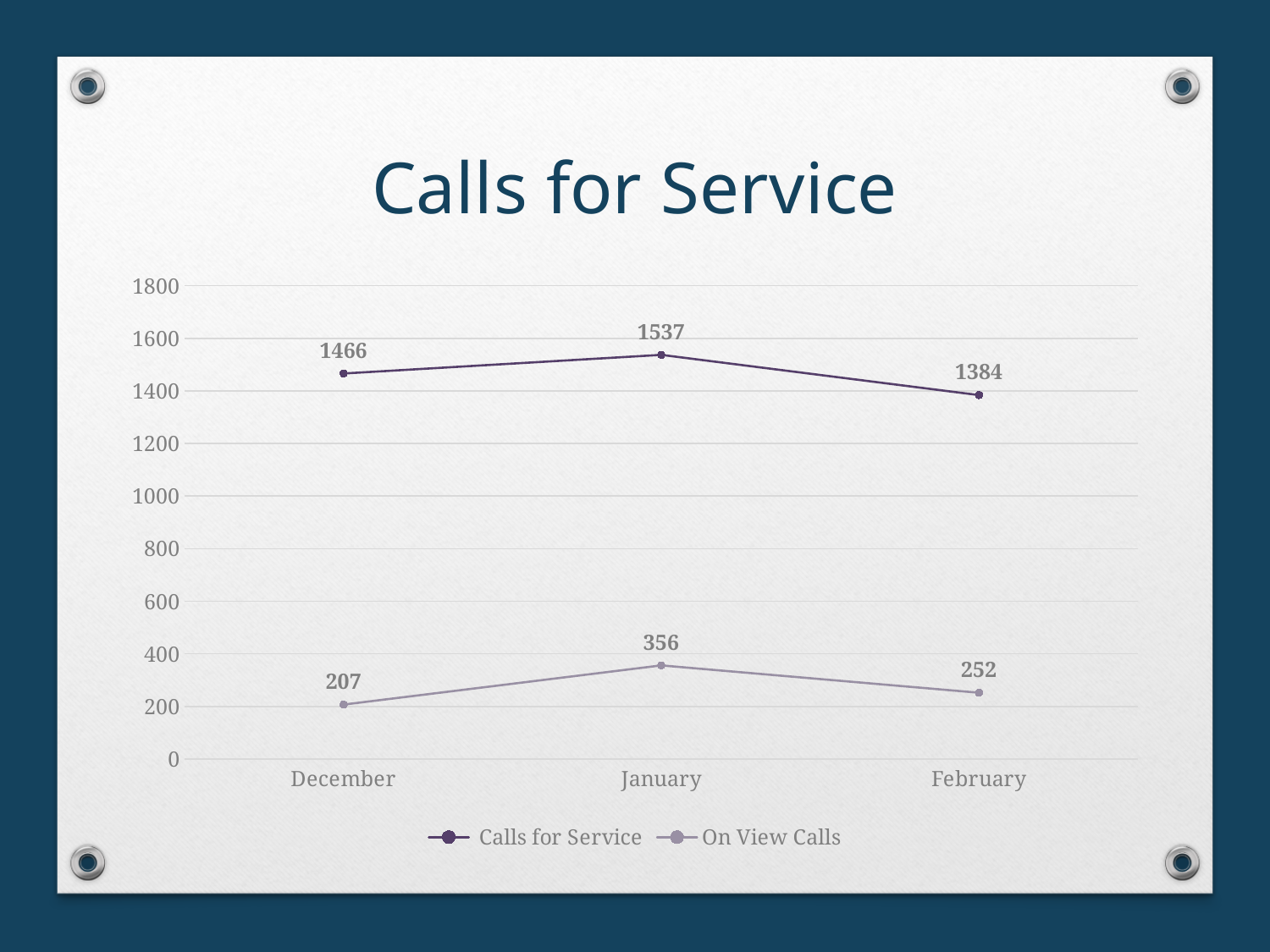
What is the value for Calls for Service in January? 1537 Is the value for On View Calls in January greater or less than 400? less What is the difference between On View Calls in January and December? 149 What is the difference between Calls for Service in January and February? 153 How many months are shown on the x axis? 3 How many series does the legend list? 2 What kind of chart is shown on the slide? line chart Which is larger: Calls for Service in December or in February? December In which month is Calls for Service highest? January What is the value for On View Calls in December? 207 What is the value for Calls for Service in February? 1384 In which month is On View Calls lowest? December